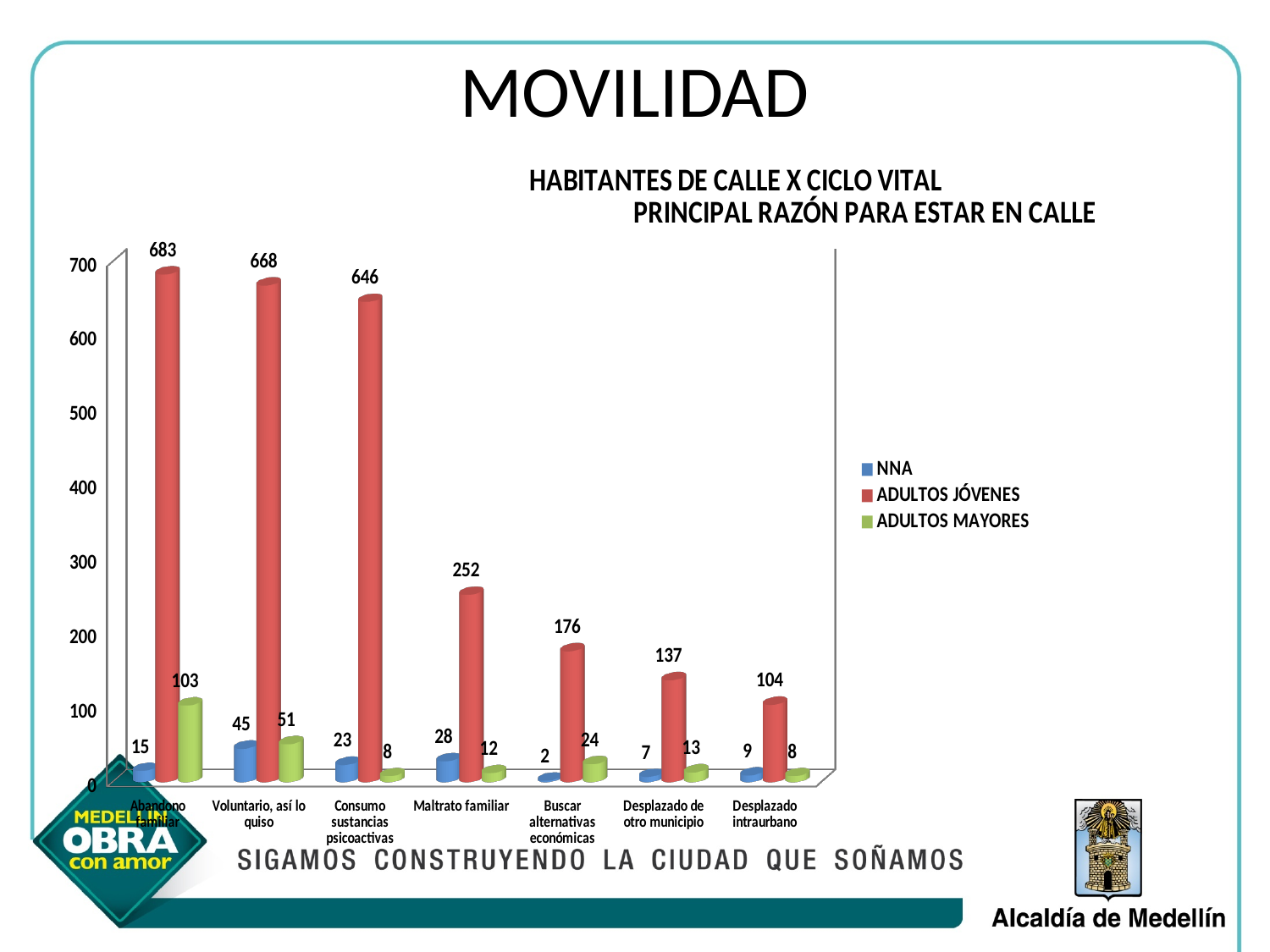
How many series does the legend list? 3 What is the value for ADULTOS MAYORES in the Buscar alternativas económicas category? 24 Which category has the highest value for ADULTOS JÓVENES? Abandono familiar Is the ADULTOS JÓVENES value for Consumo sustancias psicoactivas greater or less than 600? greater Which series is shown in red in the legend? ADULTOS JÓVENES Which is larger: the ADULTOS MAYORES value for Abandono familiar or for Voluntario, así lo quiso? Abandono familiar What is the value for ADULTOS JÓVENES in the Abandono familiar category? 683 What is the value for NNA in the Voluntario, así lo quiso category? 45 How many categories are shown on the x axis? 7 What is the difference between the ADULTOS JÓVENES values for Maltrato familiar and Buscar alternativas económicas? 76 Which category has the lowest value for NNA? Buscar alternativas económicas What kind of chart is shown on the slide? Bar chart